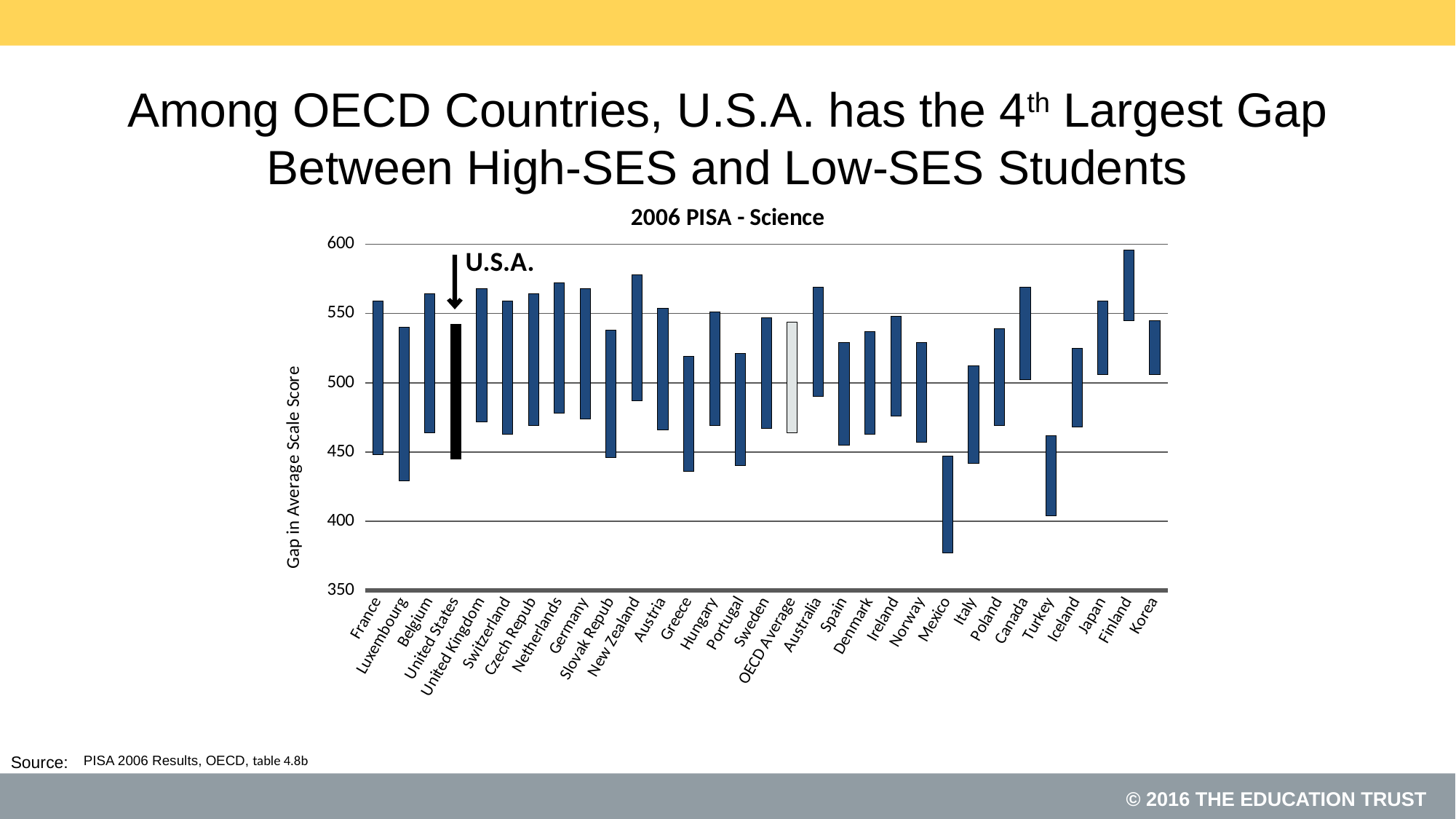
Is the lower end of the bar for Greece greater or less than 450? less Is the upper end of the bar for Finland greater or less than 550? greater What kind of chart is shown on the slide? bar chart How many categories are shown along the x axis of the chart? 31 Which country's bar extends to the lowest point on the chart? Mexico Is the lower end of the bar for Luxembourg greater or less than 450? less Which bar extends lower, Mexico or Turkey? Mexico Which country's bar reaches the highest point on the chart? Finland What is the title of the chart? 2006 PISA - Science Which country's bar is drawn in black? United States